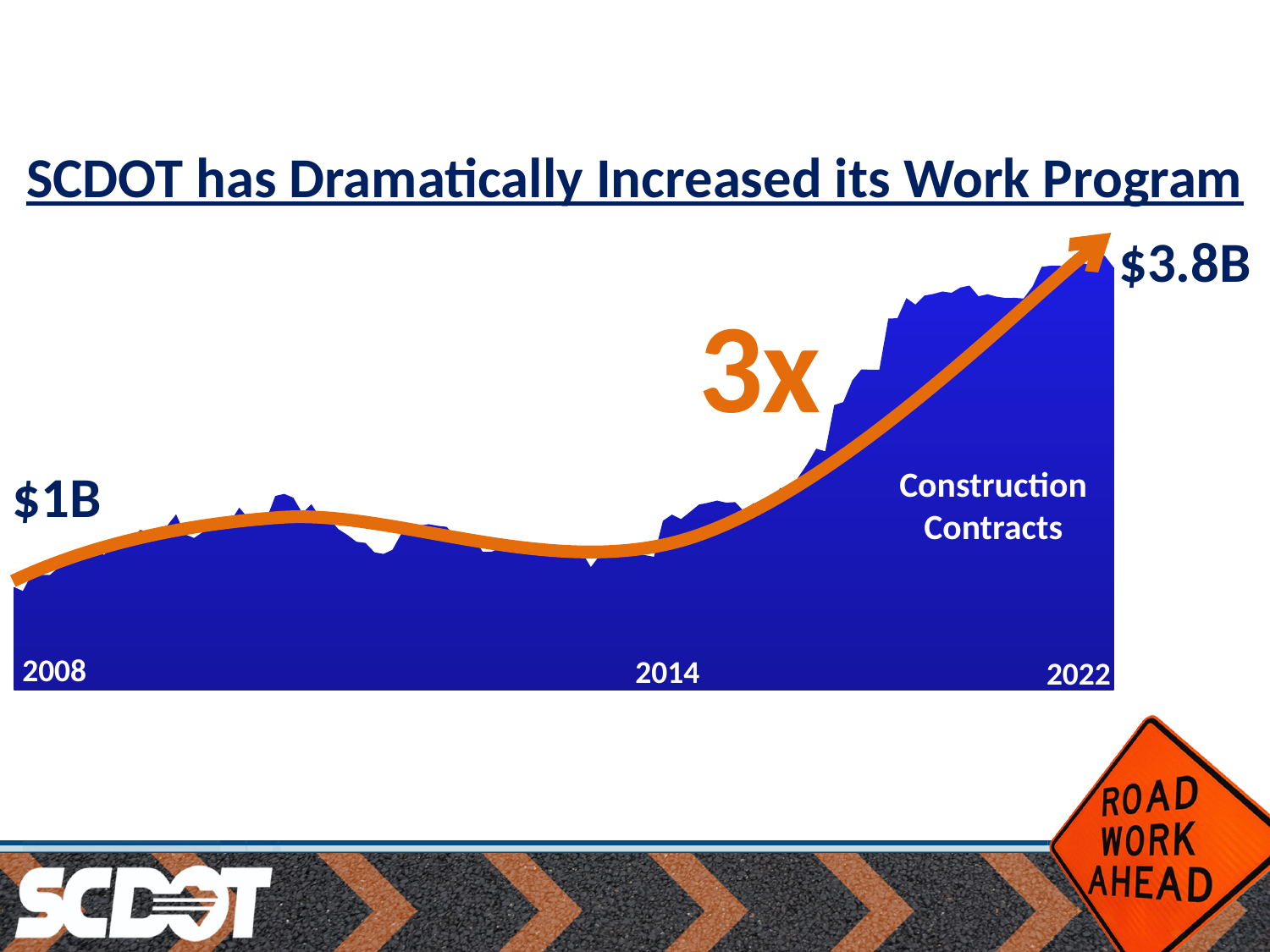
What kind of chart is shown on the slide? Area chart What value is labeled at the start of the chart in 2008? $1B What does the chart's data series represent, according to the label on the shaded area? Construction Contracts Do construction contract values rise or fall overall from 2008 to 2022? Rise How many year labels are shown along the x axis? 3 Which year has the larger labeled value, 2008 or 2022? 2022 Which year is labeled in the middle of the x axis? 2014 What value is labeled at the end of the chart in 2022? $3.8B What multiplier is printed on the chart to describe the increase? 3x What is the difference between the labeled values for 2022 and 2008? $2.8B